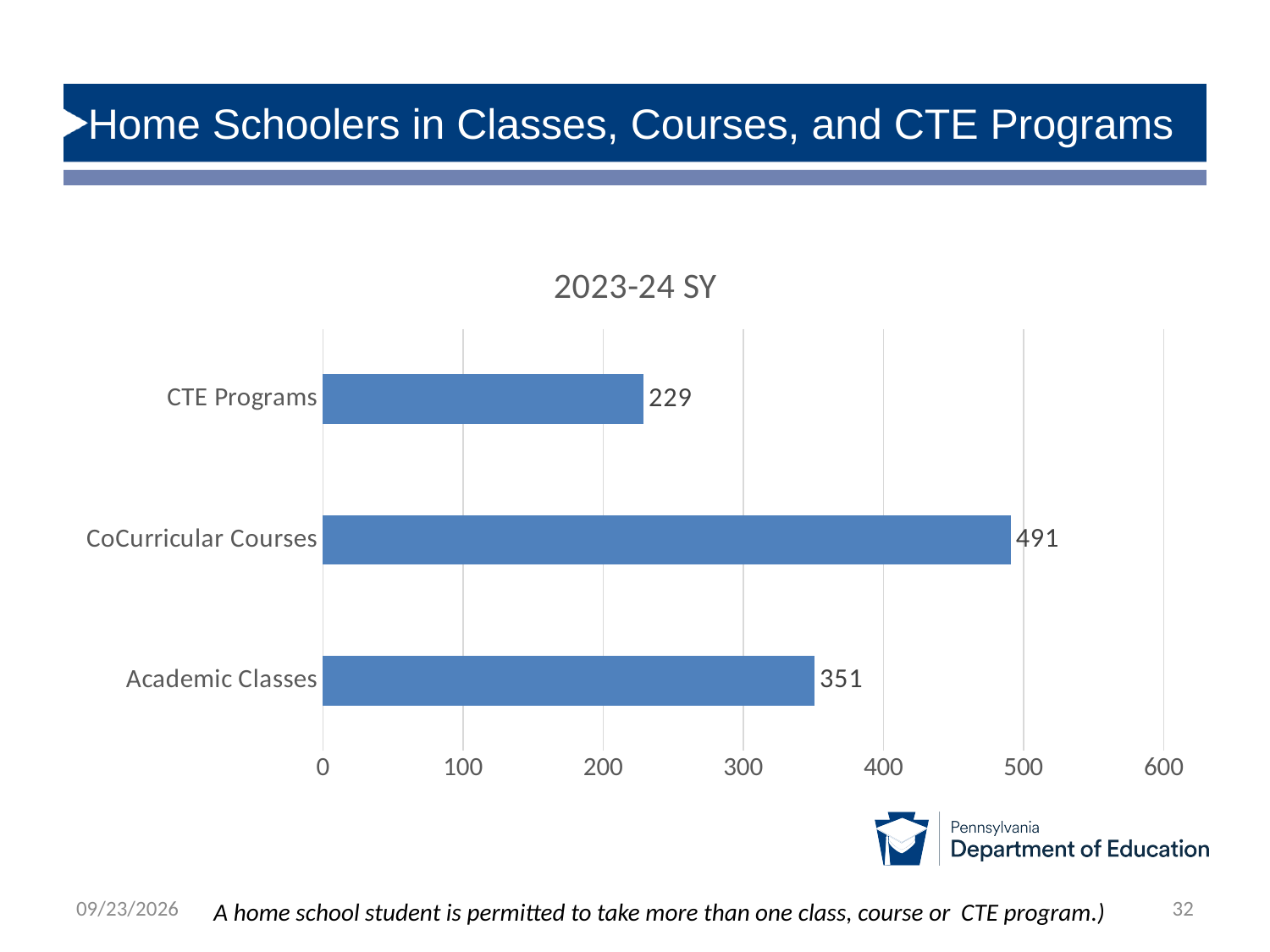
Is the value for CoCurricular Courses greater or less than 400? greater Which is larger, the value for Academic Classes or the value for CTE Programs? Academic Classes What is the difference between the values for CoCurricular Courses and Academic Classes? 140 Which category has the highest value? CoCurricular Courses What is the title of the chart? 2023-24 SY What is the value for CTE Programs? 229 What kind of chart is shown on the slide? bar chart Which category has the lowest value? CTE Programs How many categories are shown in the chart? 3 What is the value for Academic Classes? 351 What is the difference between the values for Academic Classes and CTE Programs? 122 What is the value for CoCurricular Courses? 491